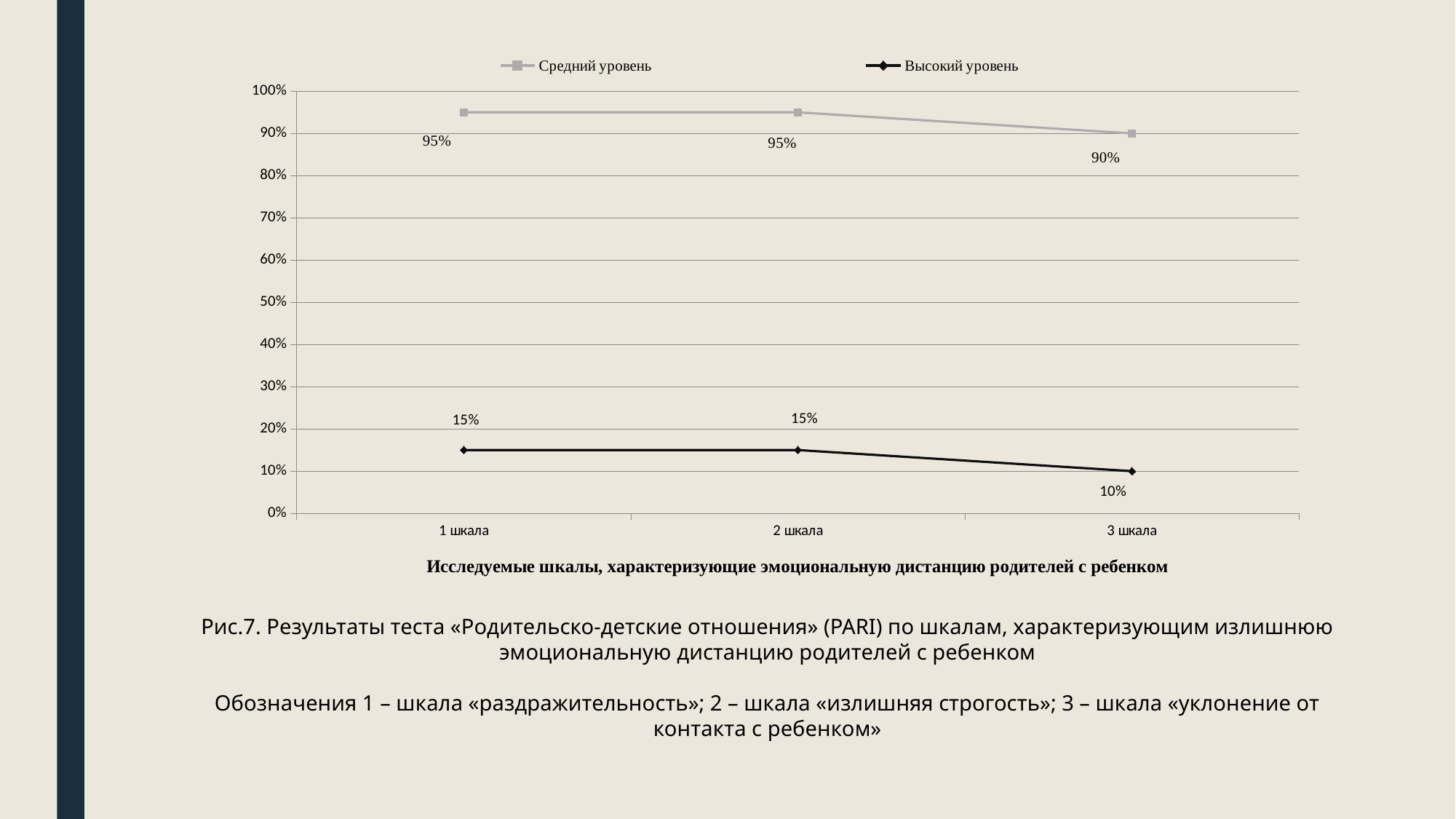
Which category has the lowest value for Высокий уровень? 3 шкала What is the value for Средний уровень at 1 шкала? 95% What is the difference between the Средний уровень values at 2 шкала and 3 шкала? 5% What is the difference between Средний уровень and Высокий уровень at 1 шкала? 80% How many series does the legend list? 2 How many categories are shown on the x axis? 3 What is the value for Высокий уровень at 3 шкала? 10% Which is larger at 3 шкала: Средний уровень or Высокий уровень? Средний уровень What type of chart is shown on the slide? line chart What is the value for Высокий уровень at 2 шкала? 15% What is the value for Средний уровень at 3 шкала? 90% Does the Высокий уровень line rise or fall from 2 шкала to 3 шкала? fall